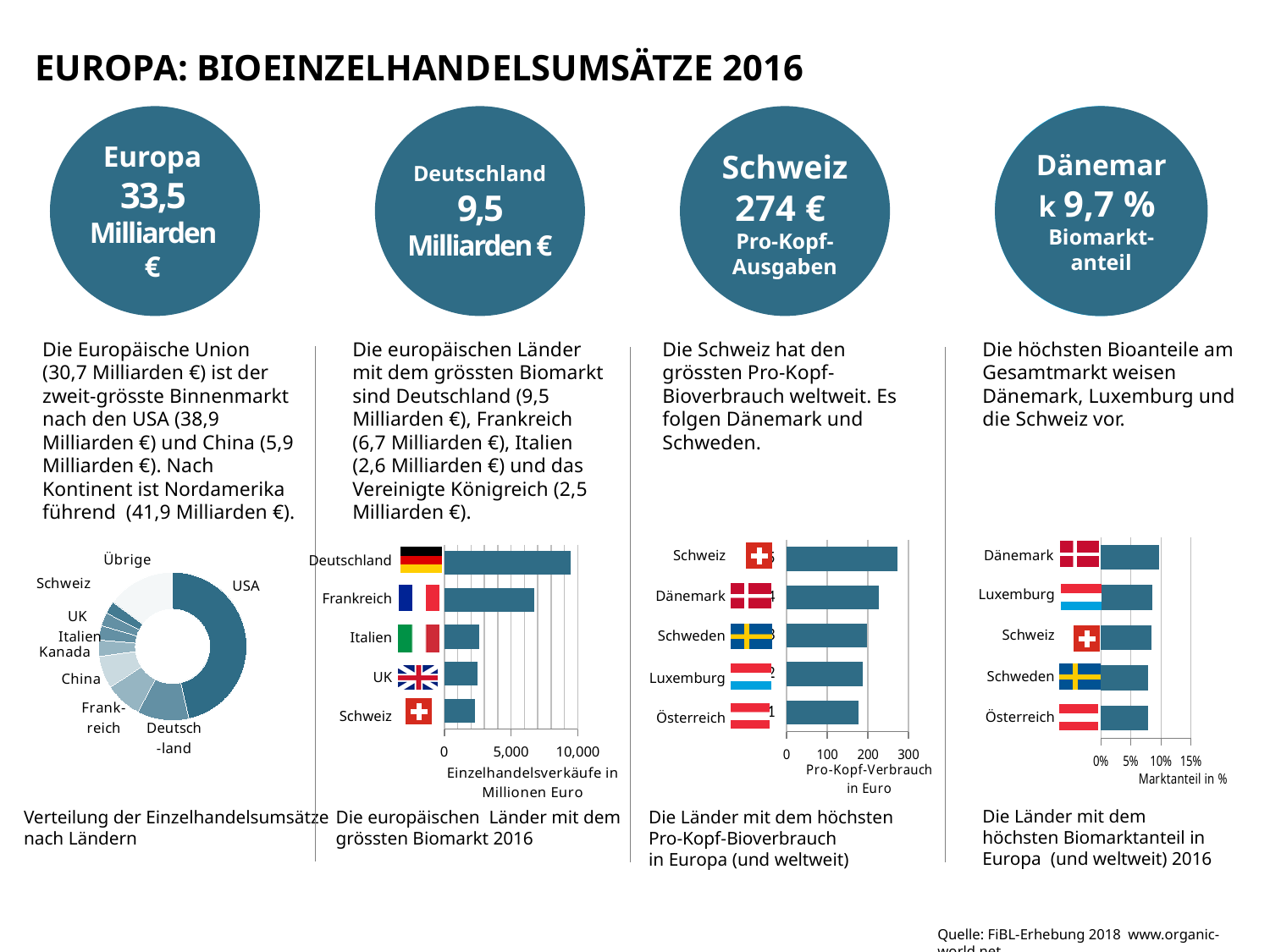
In the chart 'Die Länder mit dem höchsten Pro-Kopf-Bioverbrauch in Europa', is the value for Österreich greater or less than 200? less In the chart 'Verteilung der Einzelhandelsumsätze nach Ländern', which country has the largest slice? USA In the chart 'Die Länder mit dem höchsten Pro-Kopf-Bioverbrauch in Europa', which country has the highest value? Schweiz How many countries are shown in the chart 'Die europäischen Länder mit dem grössten Biomarkt 2016'? 5 In the chart 'Die Länder mit dem höchsten Pro-Kopf-Bioverbrauch in Europa', is the value for Schweiz greater or less than 200? greater In the chart 'Die Länder mit dem höchsten Biomarktanteil in Europa', which country has the highest market share? Dänemark What kind of chart is 'Verteilung der Einzelhandelsumsätze nach Ländern'? Pie (donut) chart In the chart 'Die europäischen Länder mit dem grössten Biomarkt 2016', is the value for Deutschland greater or less than 5,000? greater